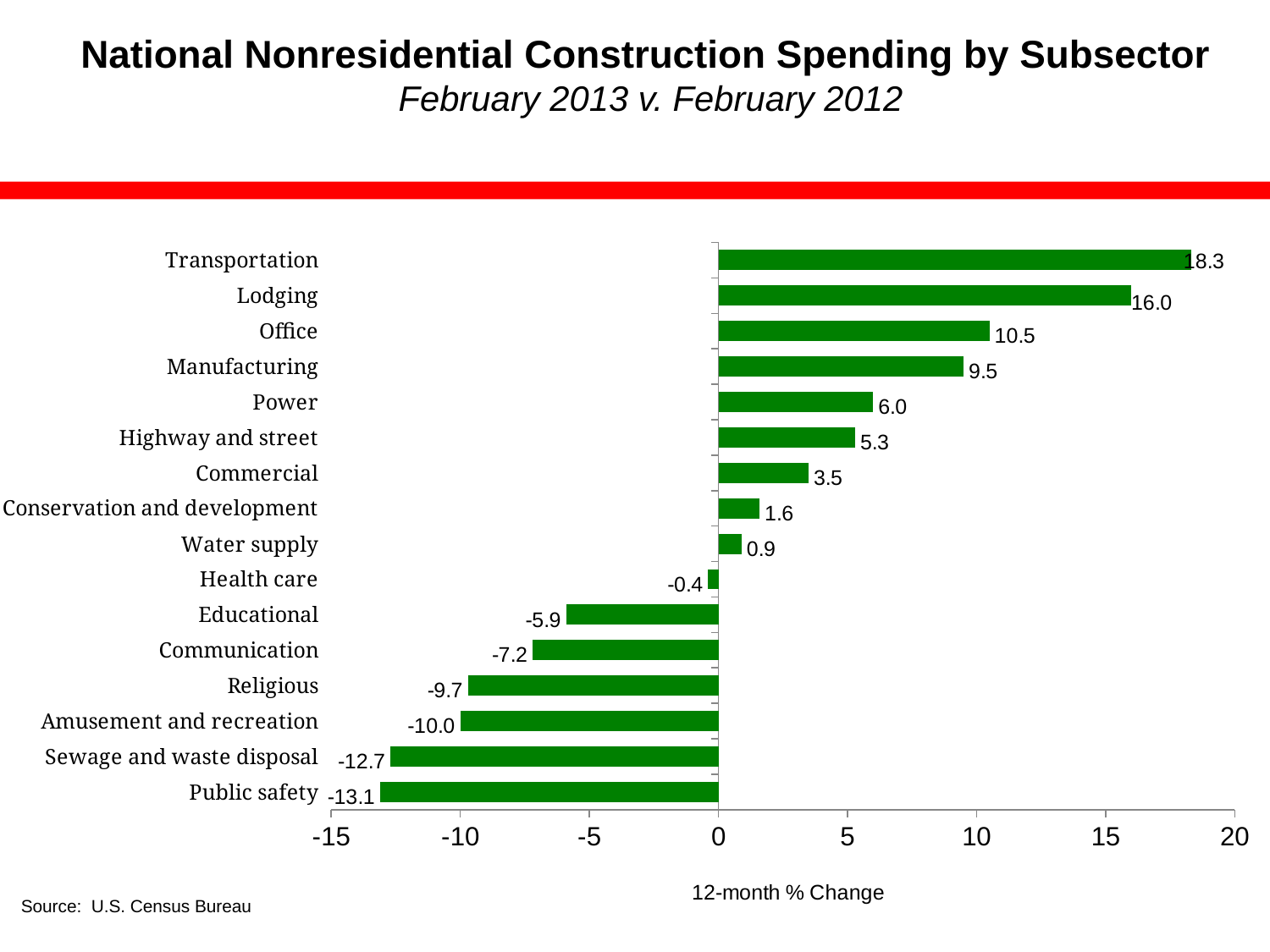
What is the 12-month % change for Transportation? 18.3 What kind of chart is shown on the slide? Bar chart What is the label of the horizontal axis? 12-month % Change What is the 12-month % change for Public safety? -13.1 What is the source cited for the chart data? U.S. Census Bureau What is the 12-month % change for Highway and street? 5.3 Which subsector has the highest 12-month % change? Transportation How many subsectors are shown in the chart? 16 Which subsector has the lowest 12-month % change? Public safety Which has a larger 12-month % change, Power or Commercial? Power Is the value for Manufacturing greater or less than 5? greater What is the difference between the 12-month % change for Lodging and for Office? 5.5